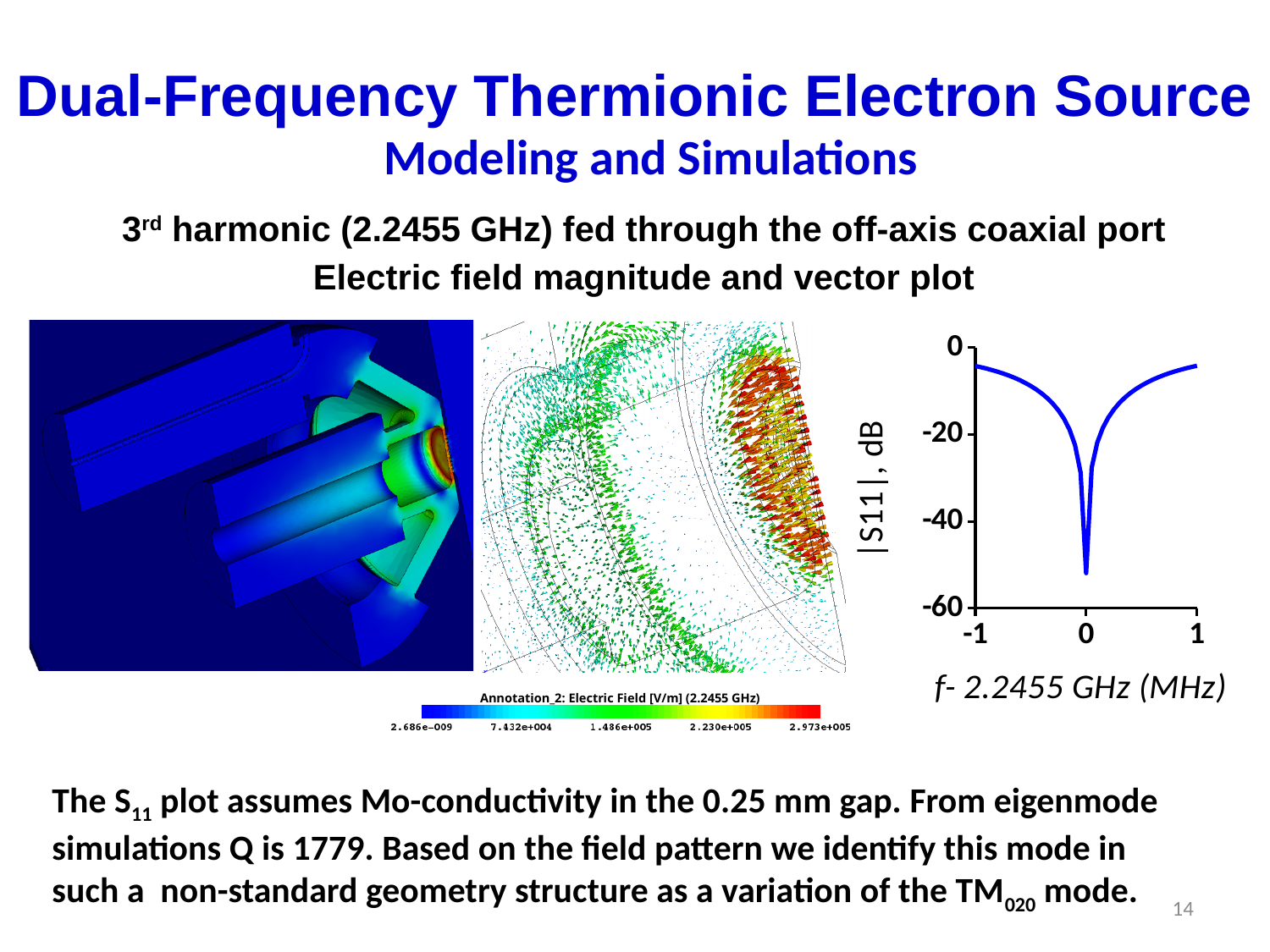
In the |S11| chart, which is larger, the value at -1 MHz or the value at 0 MHz? the value at -1 MHz What is the x-axis label of the |S11| chart? f- 2.2455 GHz (MHz) What kind of chart is the |S11| plot on the right of the slide? line chart What is the lowest tick value shown on the y-axis of the |S11| chart? -60 In the |S11| chart, does the curve rise or fall as x goes from 0 to 1? rise In the |S11| chart, at which x-axis value does the curve reach its minimum? 0 In the |S11| chart, does the curve rise or fall as x goes from -1 to 0? fall How many lines are plotted in the |S11| chart? 1 In the |S11| chart, is the value at 0 MHz greater or less than -40 dB? less What is the y-axis label of the |S11| chart? |S11|, dB In the |S11| chart, is the value at 1 MHz greater or less than -20 dB? greater In the |S11| chart, is the value at -1 MHz greater or less than -20 dB? greater